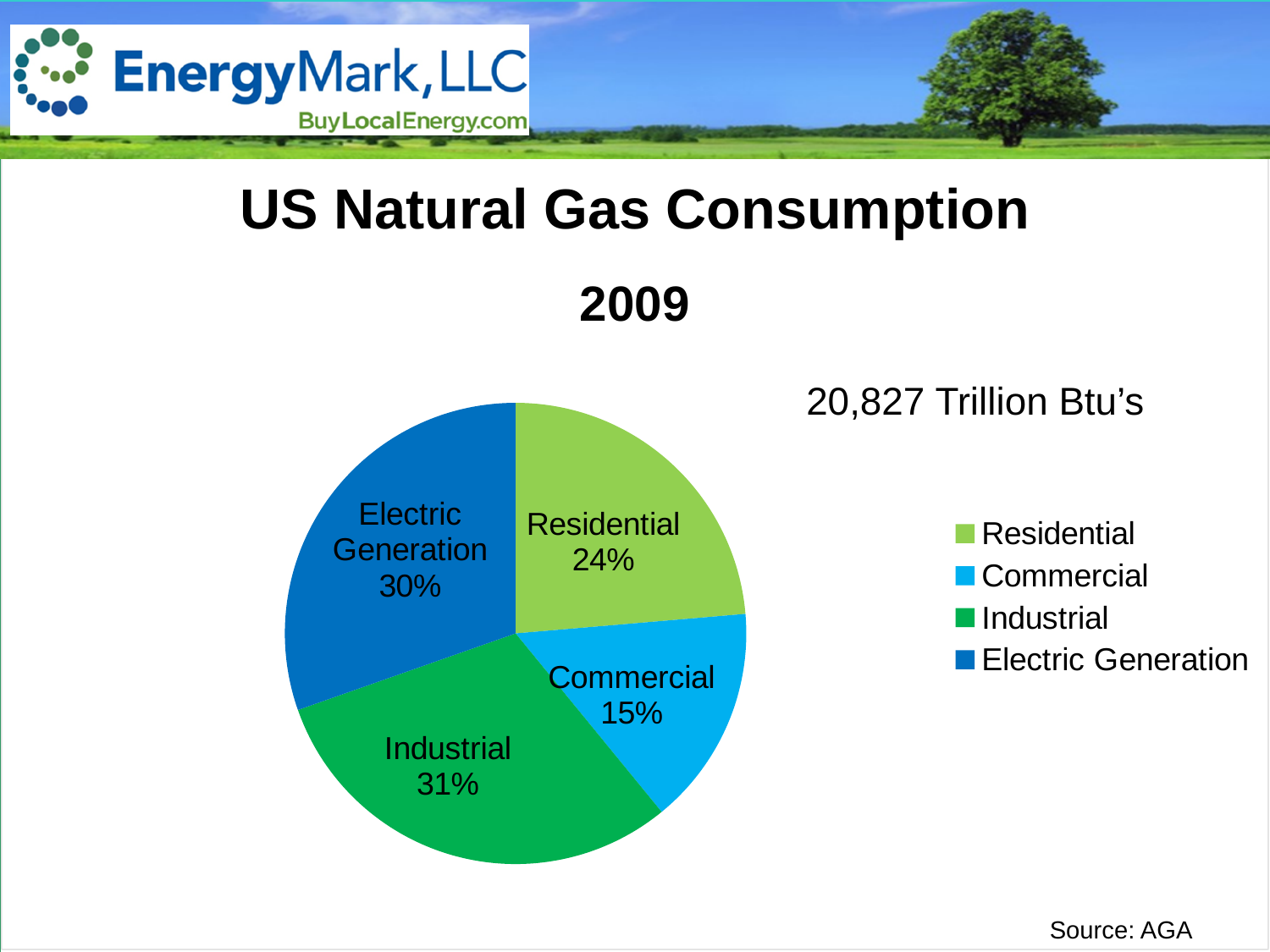
What share of US natural gas consumption in 2009 is Industrial? 31% Which sector has the largest share of US natural gas consumption in 2009? Industrial How many sectors are shown in the pie chart? 4 What total consumption figure is shown next to the pie chart? 20,827 Trillion Btu's Which is larger, the Residential share or the Electric Generation share? Electric Generation What is the difference in percentage points between the Residential and Commercial shares? 9 Which sector has the smallest share of US natural gas consumption in 2009? Commercial What share of US natural gas consumption in 2009 is Commercial? 15% What share of US natural gas consumption in 2009 is Residential? 24% What is the source cited for the chart? AGA What type of chart is shown on the slide? pie chart